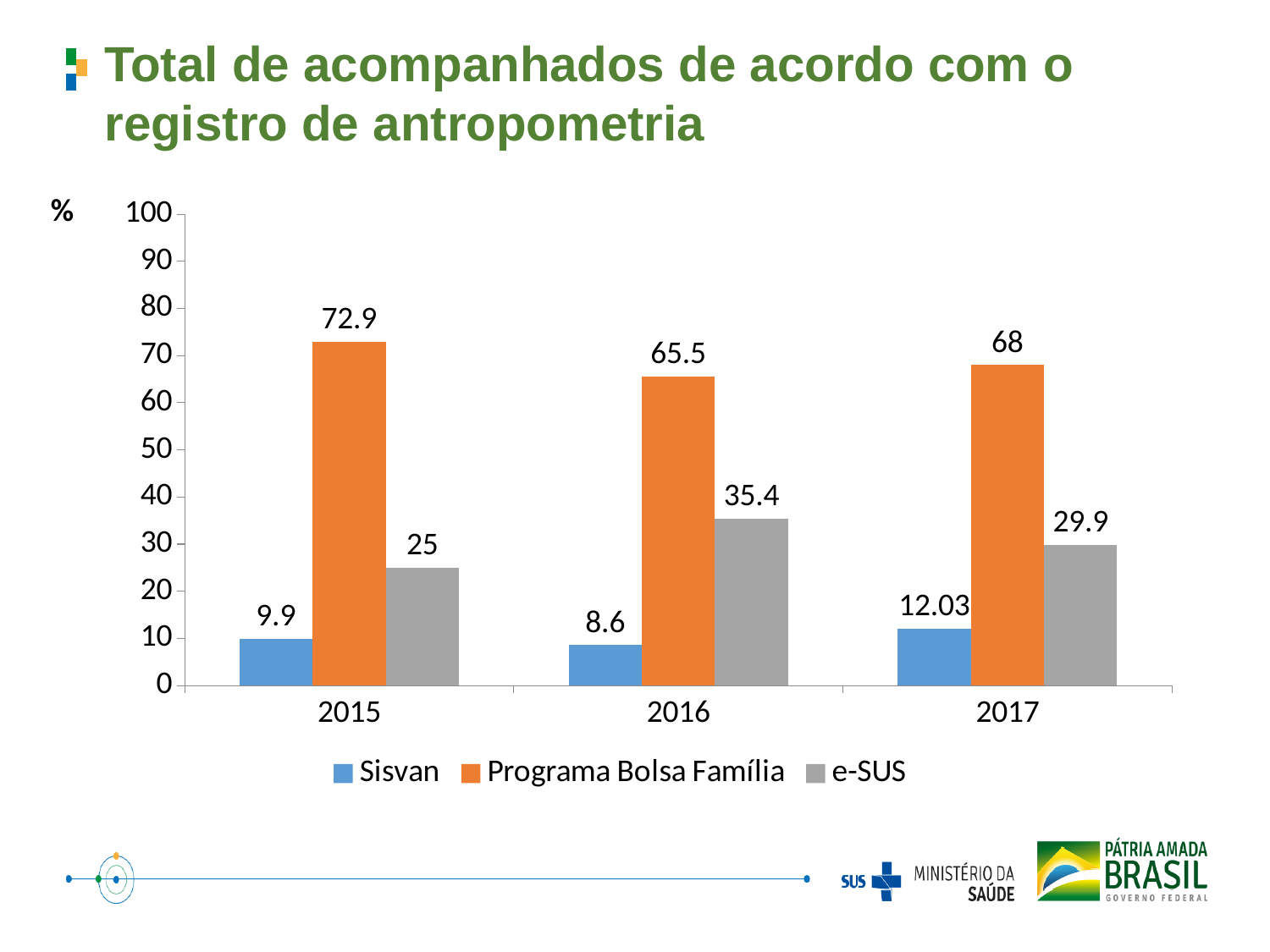
What is the value for Sisvan in 2017? 12.03 How many years are shown on the x axis? 3 In which year is the Programa Bolsa Família value highest? 2015 Which is larger in 2017: the Programa Bolsa Família value or the e-SUS value? Programa Bolsa Família What is the value for e-SUS in 2016? 35.4 In which year is the Sisvan value lowest? 2016 What is the value for Programa Bolsa Família in 2015? 72.9 What is the difference between the e-SUS values for 2016 and 2017? 5.5 Which colour represents e-SUS in the chart? grey What kind of chart is shown on the slide? bar chart How many series does the legend list? 3 Is the value for e-SUS in 2015 greater or less than 30? less